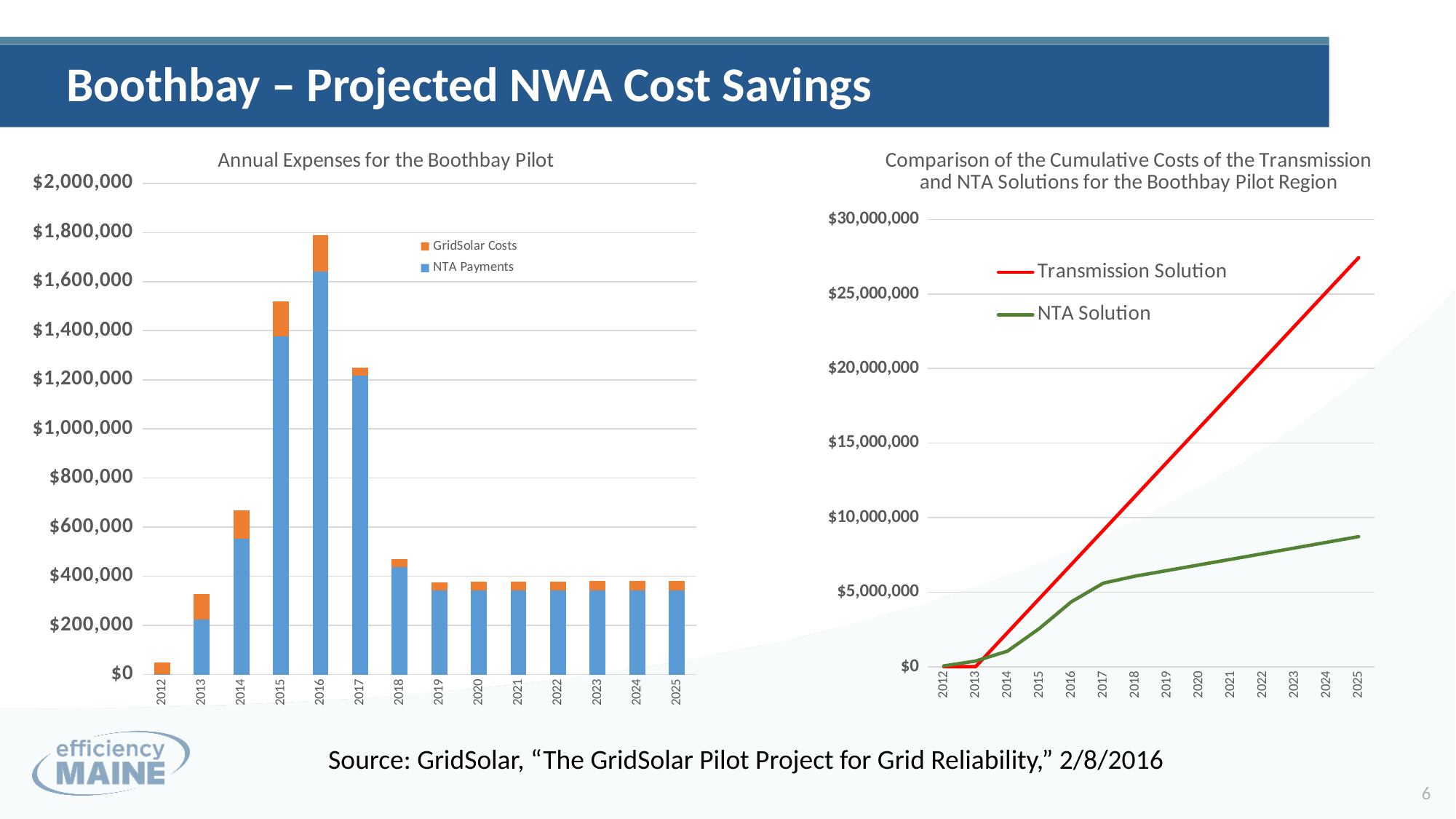
In the 'Annual Expenses for the Boothbay Pilot' chart, which year has the tallest bar? 2016 In the 'Annual Expenses for the Boothbay Pilot' chart, which colour represents GridSolar Costs? Orange In the 'Annual Expenses for the Boothbay Pilot' chart, is the total bar for 2019 greater or less than $400,000? less In the 'Comparison of the Cumulative Costs' chart on the right, which solution has the higher cumulative cost in 2025? Transmission Solution In the 'Annual Expenses for the Boothbay Pilot' chart, how many years are plotted on the x axis? 14 In the 'Annual Expenses for the Boothbay Pilot' chart, which year has the shortest bar? 2012 In the 'Annual Expenses for the Boothbay Pilot' chart, is the total bar for 2016 greater or less than $1,600,000? greater In the 'Annual Expenses for the Boothbay Pilot' chart, which year has the larger total bar, 2015 or 2017? 2015 In the 'Annual Expenses for the Boothbay Pilot' chart, what kind of chart is shown? Stacked bar chart In the 'Annual Expenses for the Boothbay Pilot' chart, how many series does the legend list? 2 In the 'Comparison of the Cumulative Costs' chart on the right, is the Transmission Solution value in 2025 greater or less than $25,000,000? greater In the 'Comparison of the Cumulative Costs' chart on the right, how many series does the legend list? 2